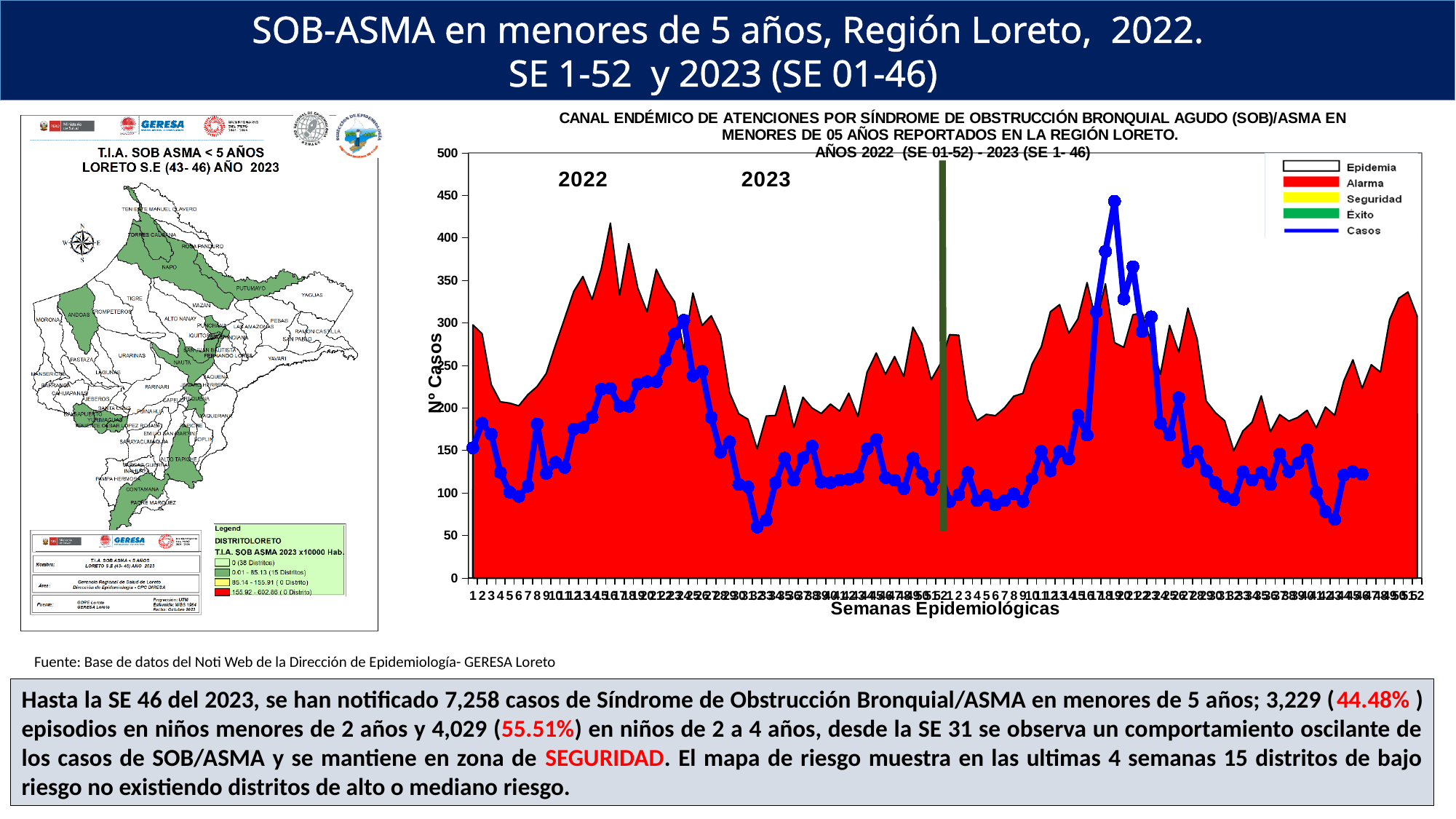
What kind of chart is the 'CANAL ENDÉMICO' chart on the right of the slide? combination area and line chart In the endemic channel chart, is the peak value of the Casos line in 2022 greater or less than 350? less How many entries does the legend of the endemic channel chart list? 5 In the endemic channel chart, which legend entry is drawn in blue? Casos In the endemic channel chart, is the lowest value of the Casos line in 2022 (around SE 32) greater or less than 100? less In the endemic channel chart, do the Casos values rise or fall between SE 25 and SE 32 of 2022? fall What is the highest value shown on the vertical axis of the endemic channel chart? 500 In the endemic channel chart, is the peak value of the Casos line in 2023 greater or less than 400? greater In the endemic channel chart, is the highest point of the Casos line in 2022 or in 2023? 2023 In the endemic channel chart, which is larger: the peak of the Casos line in 2022 or the peak of the Casos line in 2023? 2023 What is the label of the vertical axis of the endemic channel chart? Nº Casos In the endemic channel chart, do the Casos values rise or fall between SE 12 and SE 18 of 2023? rise